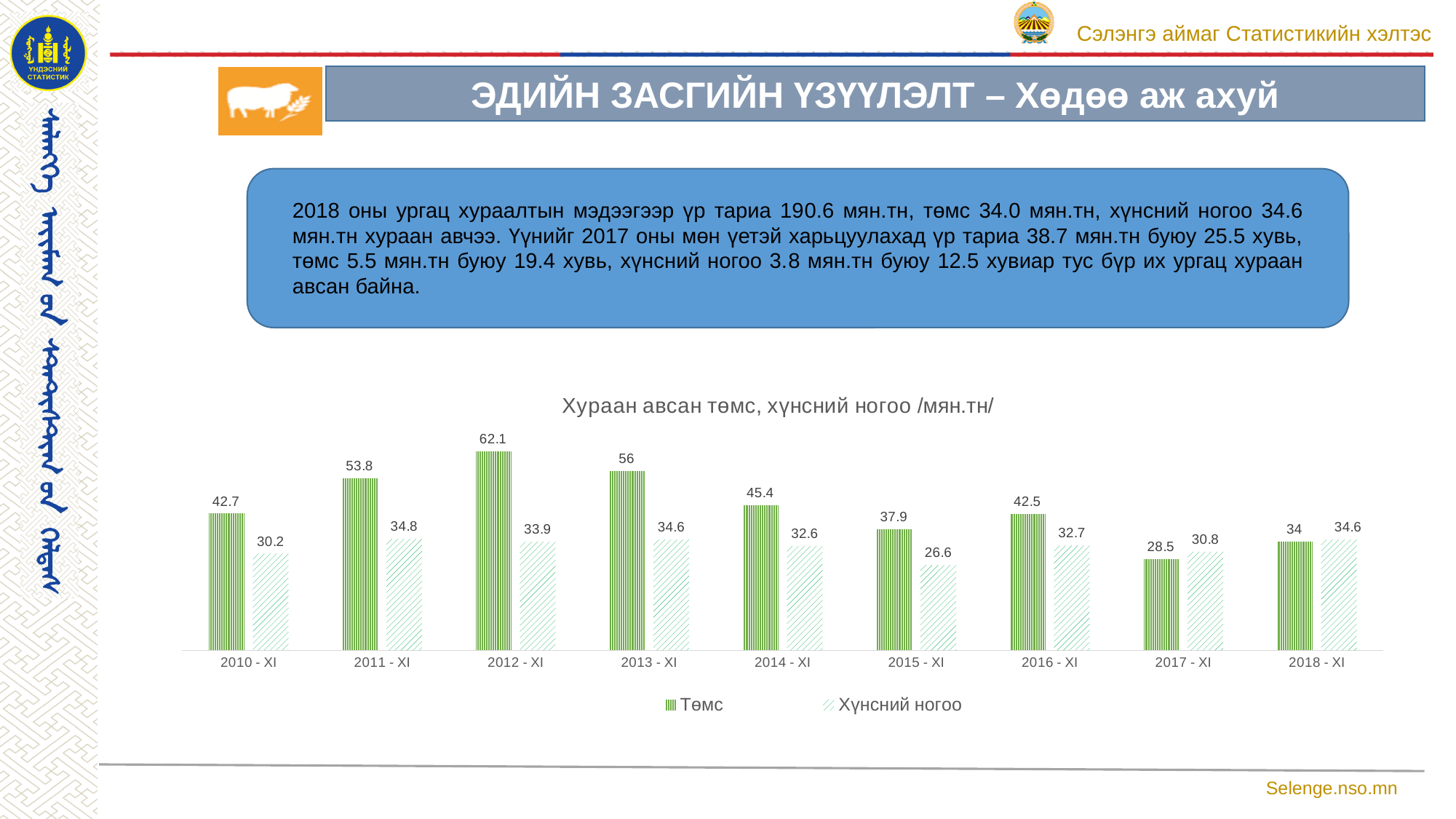
What kind of chart is shown on the slide? Bar chart What is the value for Төмс in 2012 - XI? 62.1 In which year is the Төмс value lowest? 2017 - XI How many series does the legend list? 2 What is the difference between the Төмс values in 2012 - XI and 2013 - XI? 6.1 In which year is the Төмс value highest? 2012 - XI What is the value for Төмс in 2018 - XI? 34 Which is larger in 2017 - XI: Төмс or Хүнсний ногоо? Хүнсний ногоо What is the title of the chart? Хураан авсан төмс, хүнсний ногоо /мян.тн/ What is the value for Хүнсний ногоо in 2015 - XI? 26.6 In which year is the Хүнсний ногоо value lowest? 2015 - XI How many years are shown on the x axis? 9